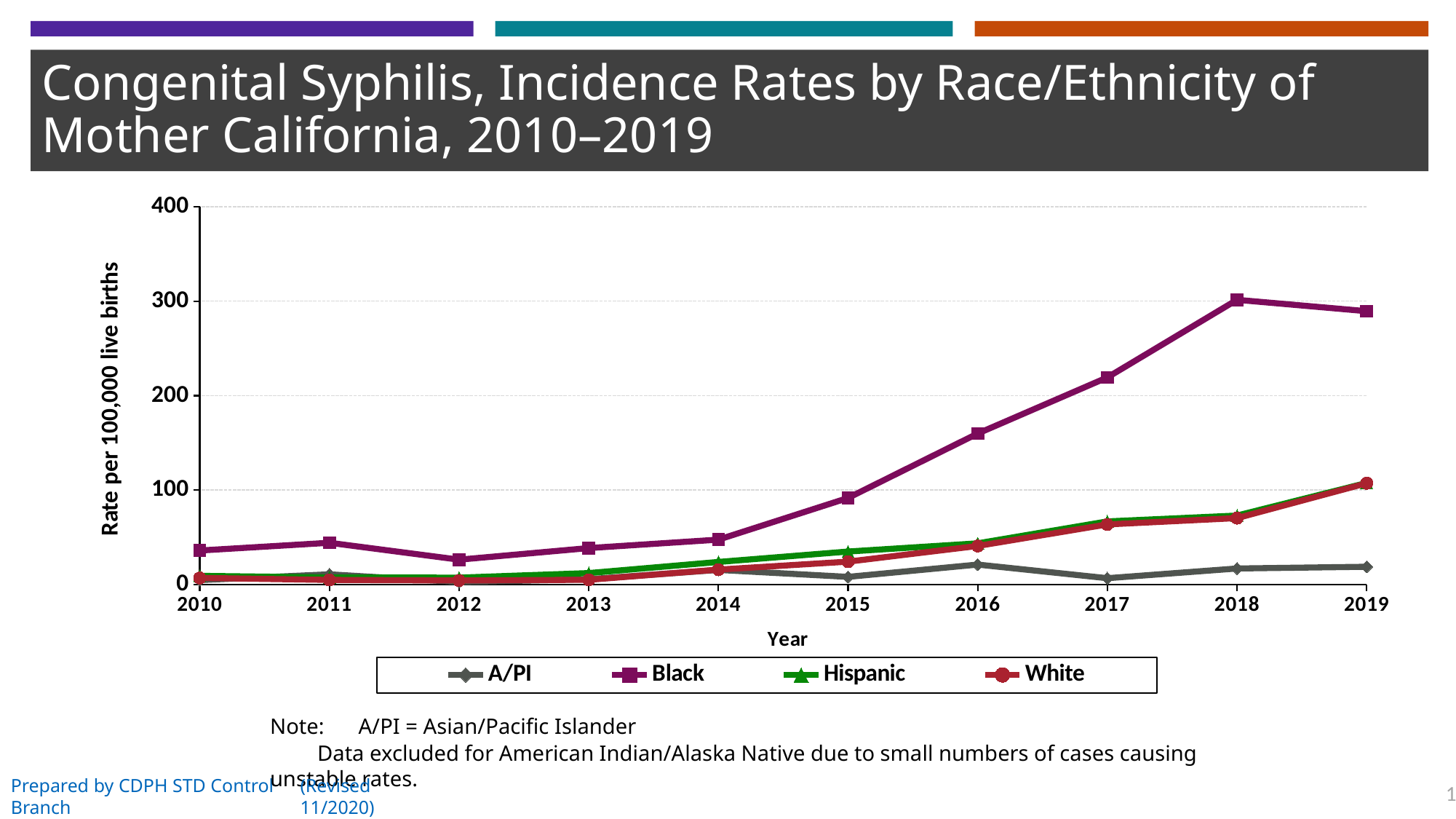
Which race/ethnicity has the highest rate in 2019? Black Which is larger in 2018, the rate for Black mothers or the rate for White mothers? Black Is the rate for A/PI mothers in 2016 greater or less than 100? less What is the label on the y axis? Rate per 100,000 live births What does A/PI stand for according to the note on the slide? Asian/Pacific Islander How many years are plotted along the x axis? 10 Which race/ethnicity has the lowest rate in 2019? A/PI How many series does the legend list? 4 Is the rate for Black mothers in 2017 greater or less than 200? greater Is the rate for Black mothers in 2016 greater or less than 200? less What kind of chart is shown on the slide? line chart Does the rate for Black mothers generally rise or fall from 2012 to 2018? rise